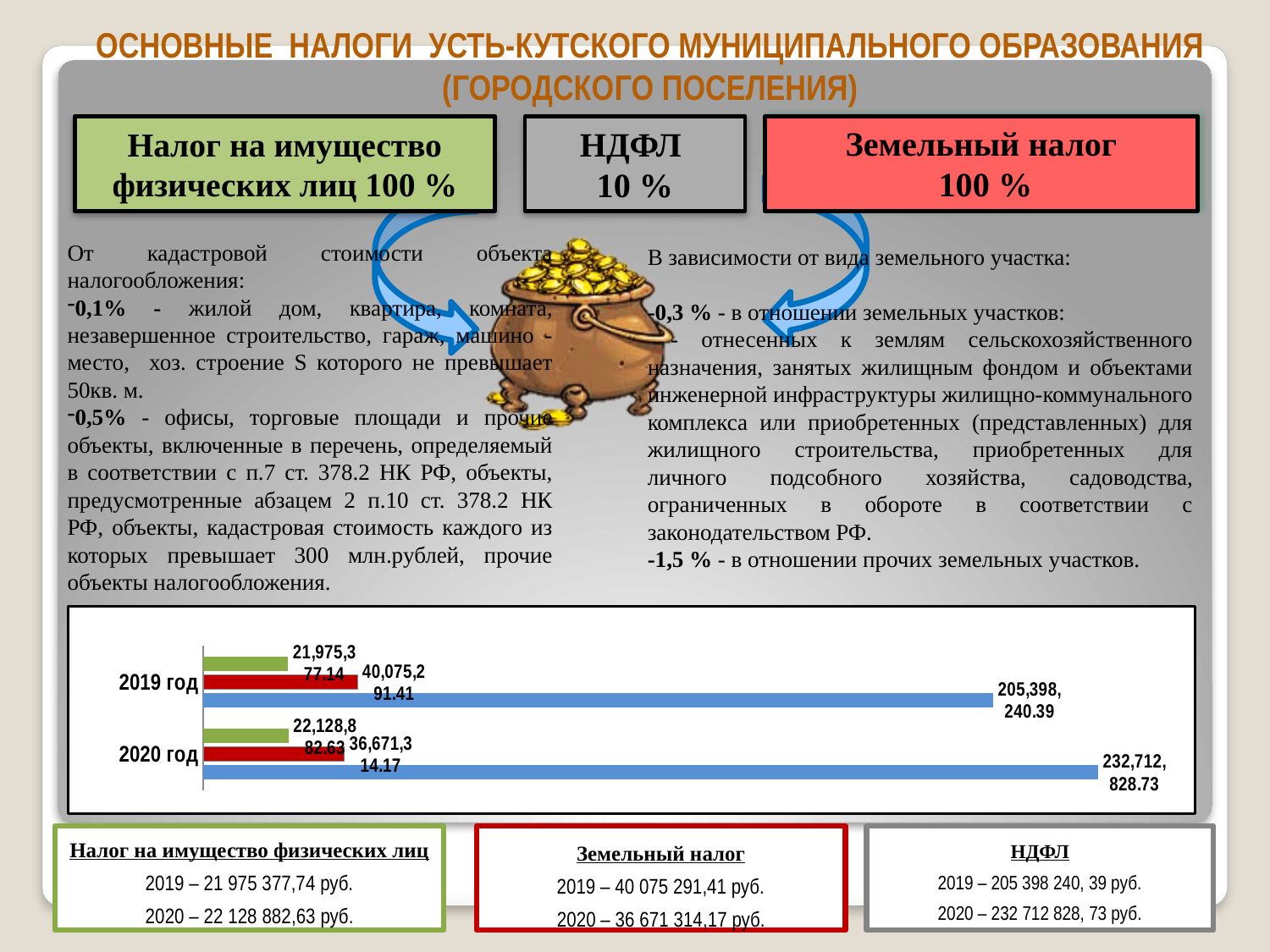
In the bar chart, what is the value of the longest (blue) bar for 2019 год? 205,398,240.39 Which bar is the shortest in the whole bar chart? the green bar for 2019 год Which bar is the longest in the whole bar chart? the blue bar for 2020 год In the bar chart, what is the value of the red bar for 2020 год? 36,671,314.17 How many categories (years) does the bar chart show? 2 Does the blue bar rise or fall from 2019 год to 2020 год? rise In the bar chart, what is the value of the longest (blue) bar for 2020 год? 232,712,828.73 Which year has the larger blue bar in the bar chart, 2019 год or 2020 год? 2020 год Which year has the larger red bar in the bar chart, 2019 год or 2020 год? 2019 год In the bar chart, what is the value of the green bar for 2019 год? 21,975,377.14 How many bars are plotted for each year in the bar chart? 3 What kind of chart is shown at the bottom of the slide? bar chart